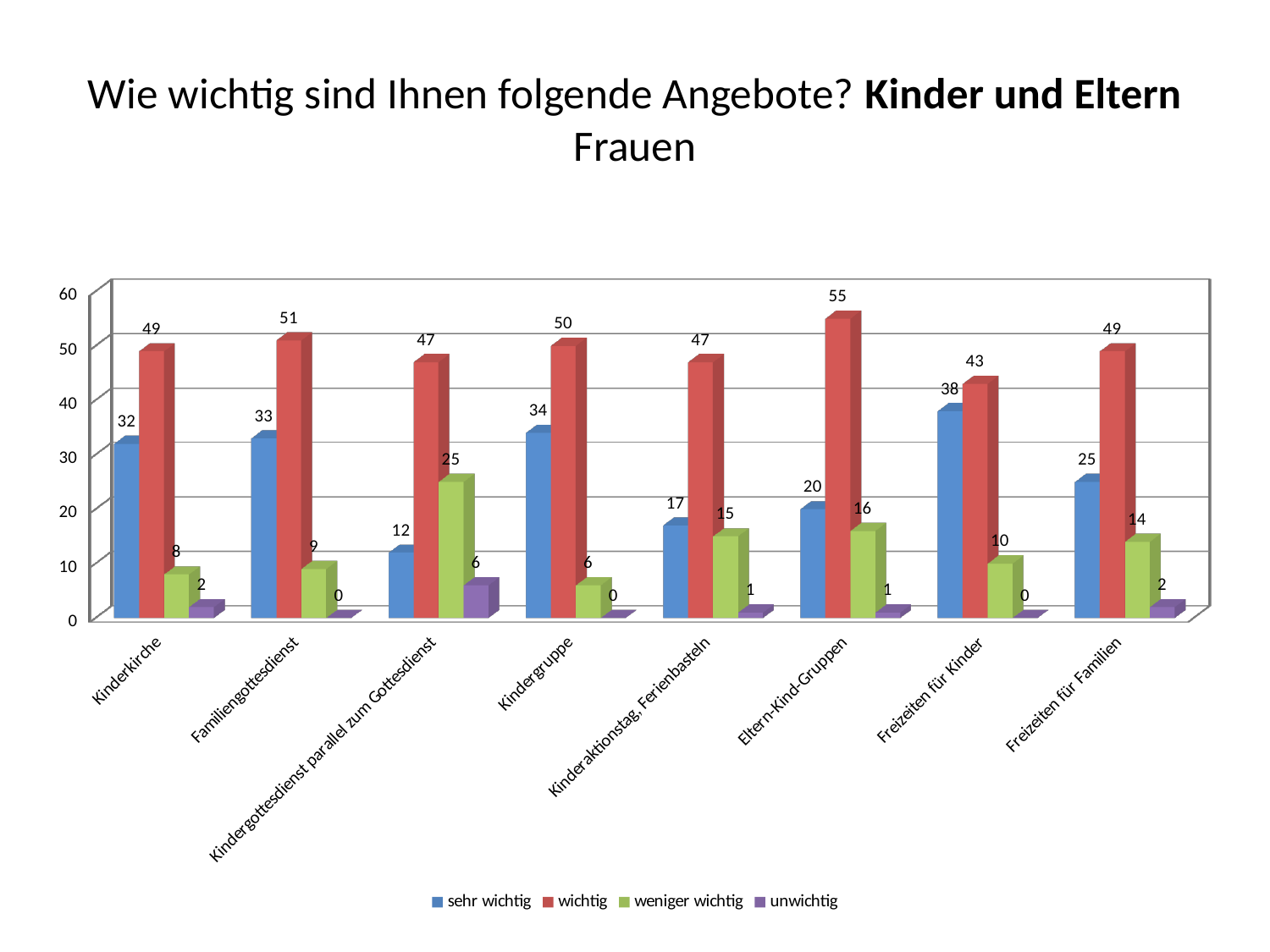
What kind of chart is shown on the slide? bar chart Which category has the lowest value for "sehr wichtig"? Kindergottesdienst parallel zum Gottesdienst What is the difference between the "wichtig" and "sehr wichtig" values for Freizeiten für Kinder? 5 Which is larger for Kindergruppe: the "sehr wichtig" value or the "weniger wichtig" value? sehr wichtig Which category has the highest value for "wichtig"? Eltern-Kind-Gruppen What is the value for "unwichtig" for Freizeiten für Familien? 2 What is the value for "sehr wichtig" for Kinderkirche? 32 Which colour represents the "unwichtig" series? purple What is the value for "wichtig" for Eltern-Kind-Gruppen? 55 What is the value for "weniger wichtig" for Kindergottesdienst parallel zum Gottesdienst? 25 How many categories are shown on the x axis? 8 How many series does the legend list? 4